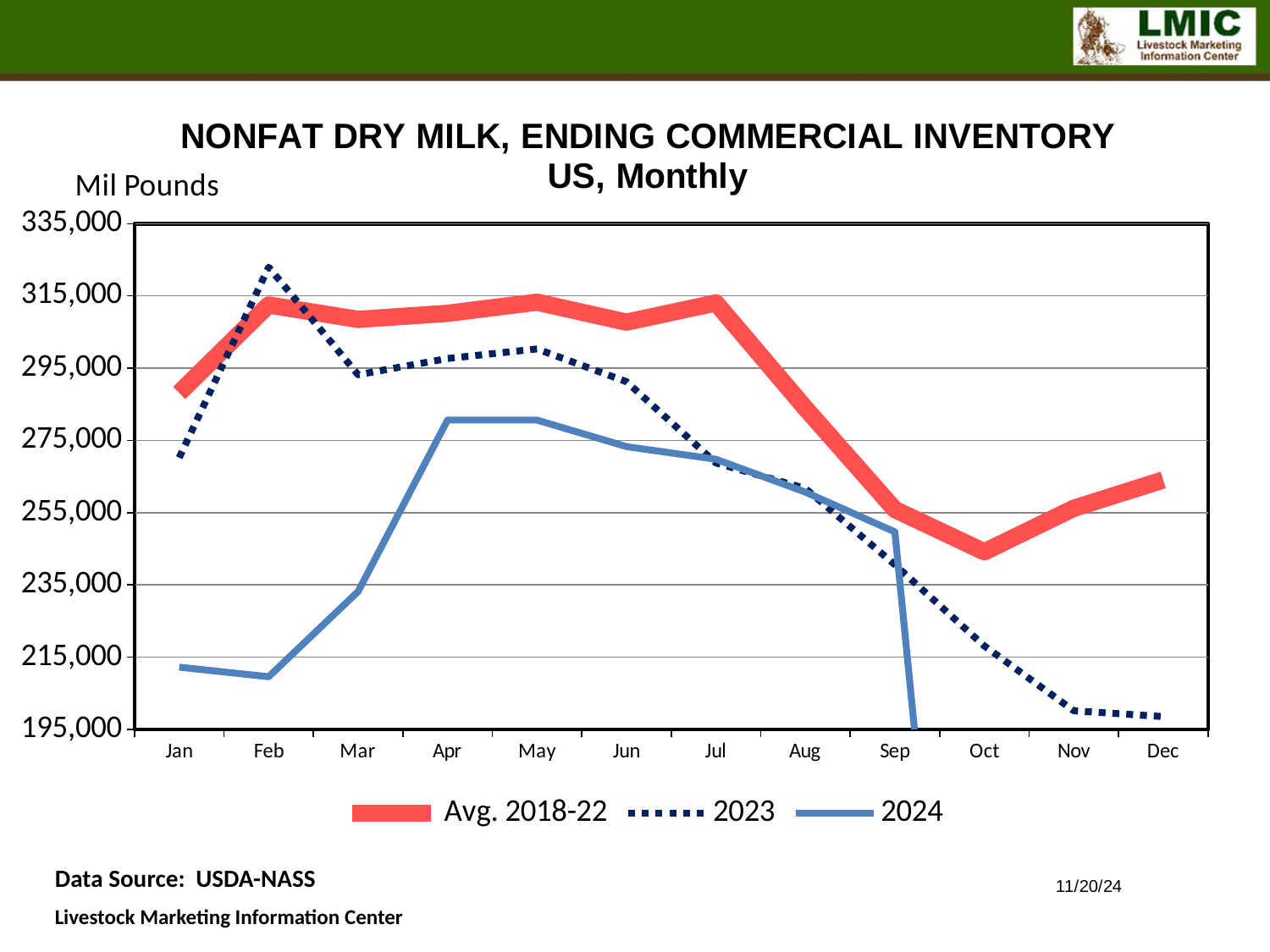
What unit label is shown above the y axis? Mil Pounds In which month does the 2023 series reach its highest value? Feb Is the Avg. 2018-22 value for Oct greater or less than 255,000? less In Jan, which series is higher: Avg. 2018-22 or 2024? Avg. 2018-22 In Apr, which series is higher: 2023 or 2024? 2023 How many months are shown along the x axis? 12 What kind of chart is shown on the slide? line chart Is the 2023 value for Dec greater or less than 215,000? less In which month is the Avg. 2018-22 series at its lowest? Oct Does the 2023 series rise or fall from Jul to Dec? fall Is the 2023 value for Feb greater or less than 315,000? greater How many series does the legend list? 3